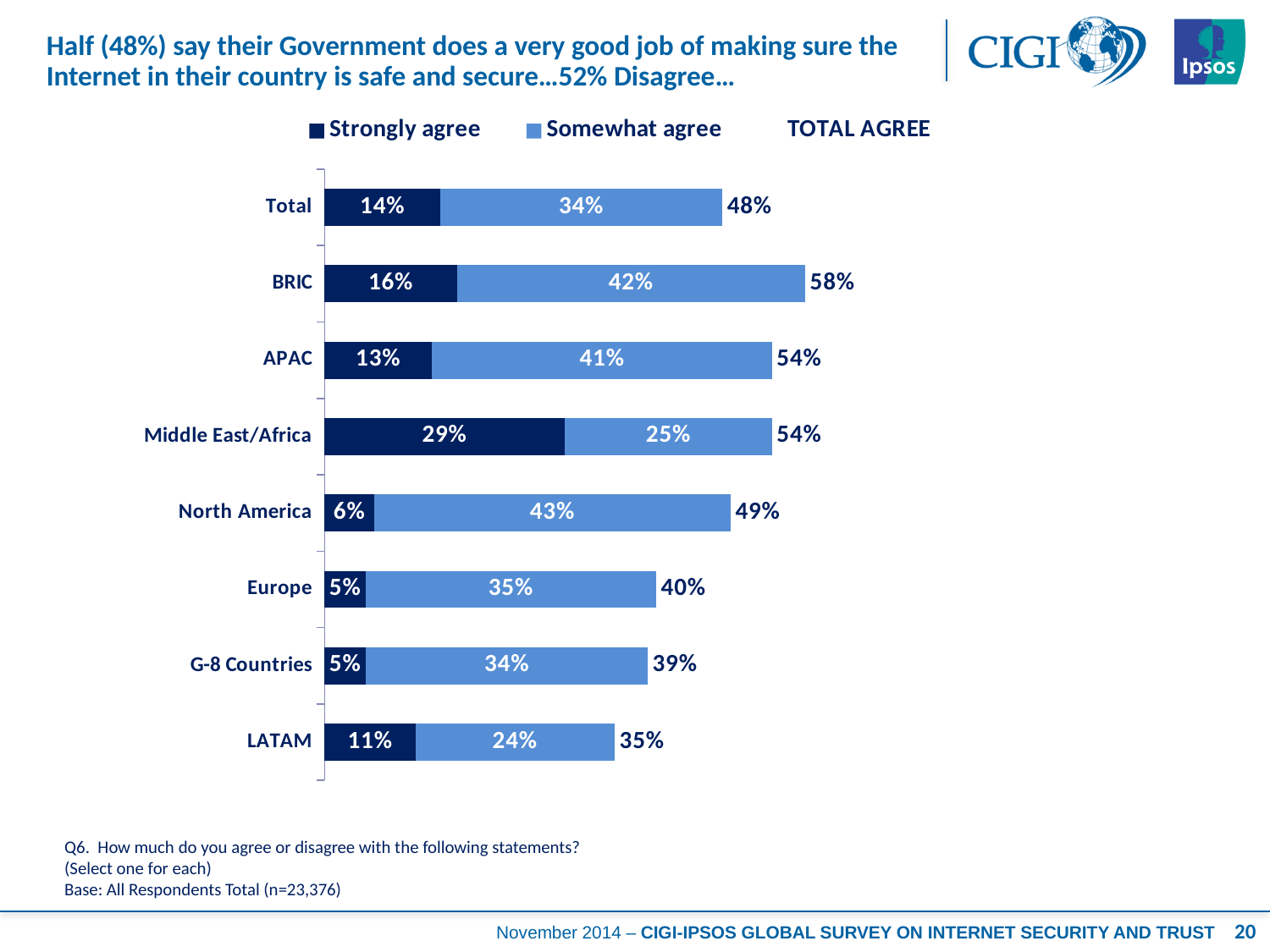
What is the 'Strongly agree' value for Middle East/Africa? 29% Which is larger, the 'Somewhat agree' value for APAC or for Europe? APAC What is the total of the stacked bar for G-8 Countries? 39% What kind of chart is shown on the slide? Stacked bar chart How many series does the legend list? 3 What is the 'Somewhat agree' value for North America? 43% Which category has the lowest TOTAL AGREE value? LATAM What is the TOTAL AGREE value for BRIC? 58% Which category has the highest TOTAL AGREE value? BRIC How many categories are shown on the chart? 8 What is the difference between the TOTAL AGREE values for BRIC and LATAM? 23% Which category has the highest 'Strongly agree' value? Middle East/Africa